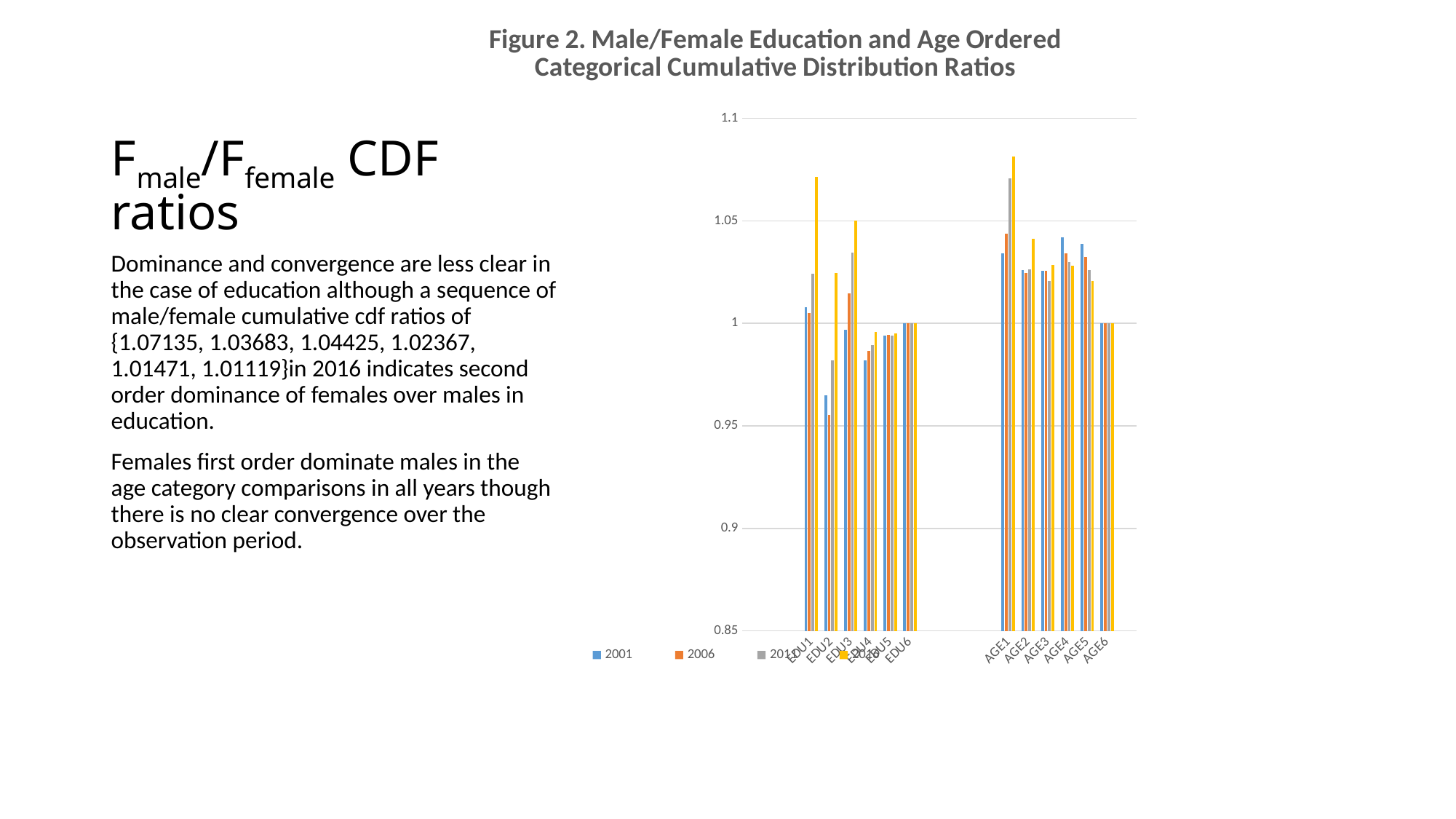
Which is larger, the 2016 value for EDU1 or the 2016 value for EDU2? EDU1 Is the 2001 value for AGE4 greater or less than 1? greater Is the 2001 value for EDU4 greater or less than 1? less Is the 2016 value for EDU1 greater or less than 1.05? greater Which year has the lowest value for EDU2? 2006 How many series does the chart legend list? 4 What is the title of the chart? Figure 2. Male/Female Education and Age Ordered Categorical Cumulative Distribution Ratios Which year has the highest value for EDU1? 2016 What kind of chart is shown on the slide? bar chart How many categories are shown on the x axis of the chart? 12